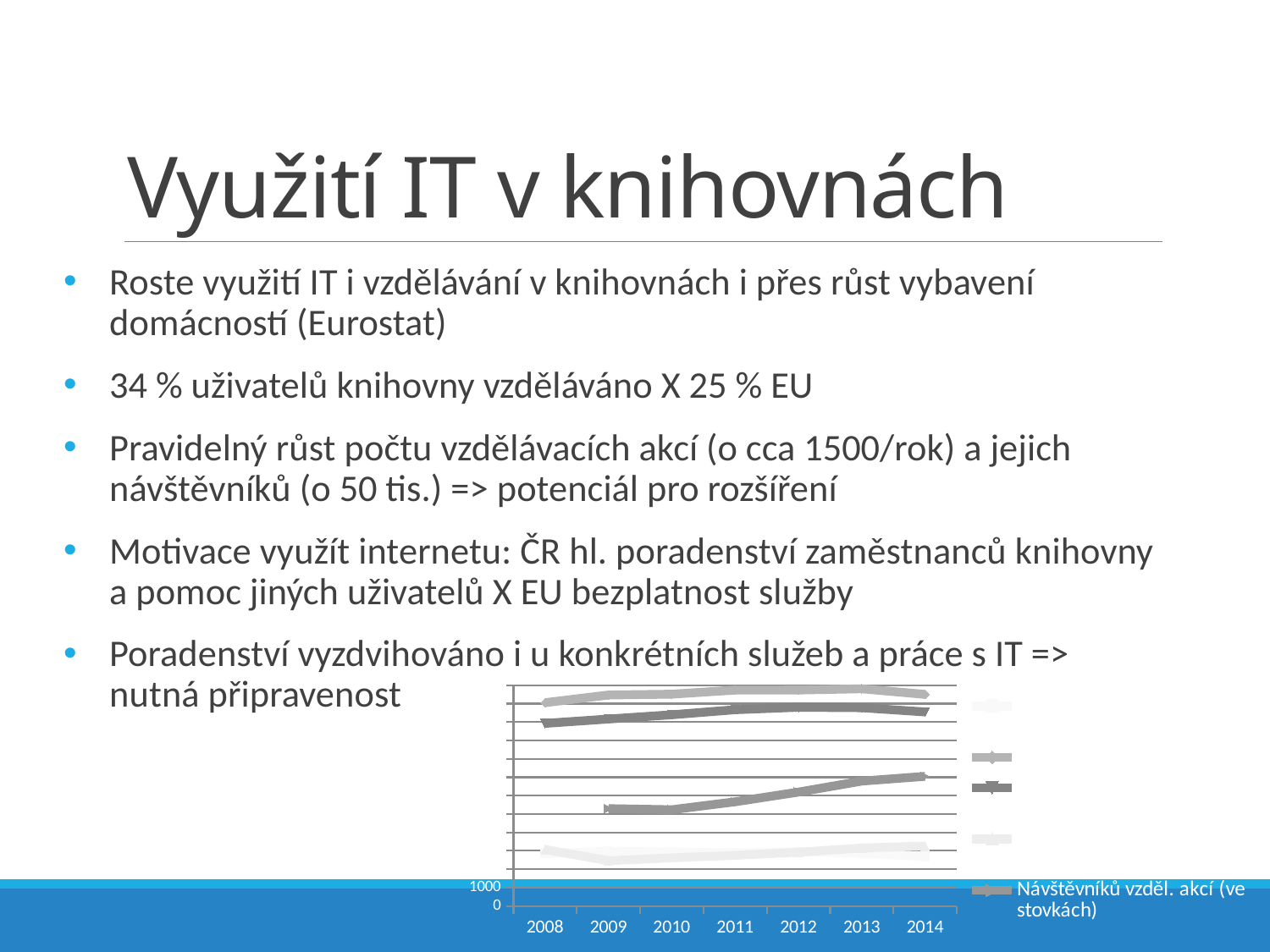
What is the last year shown on the x axis of the chart? 2014 How many years are shown on the x axis of the chart? 7 What is the lowest value labelled on the y axis of the chart? 0 In which year does the medium-grey rising line begin? 2009 What kind of chart is shown at the bottom right of the slide? line chart Does the medium-grey line that starts in 2009 rise or fall between 2009 and 2014? rise What is the first year shown on the x axis of the chart? 2008